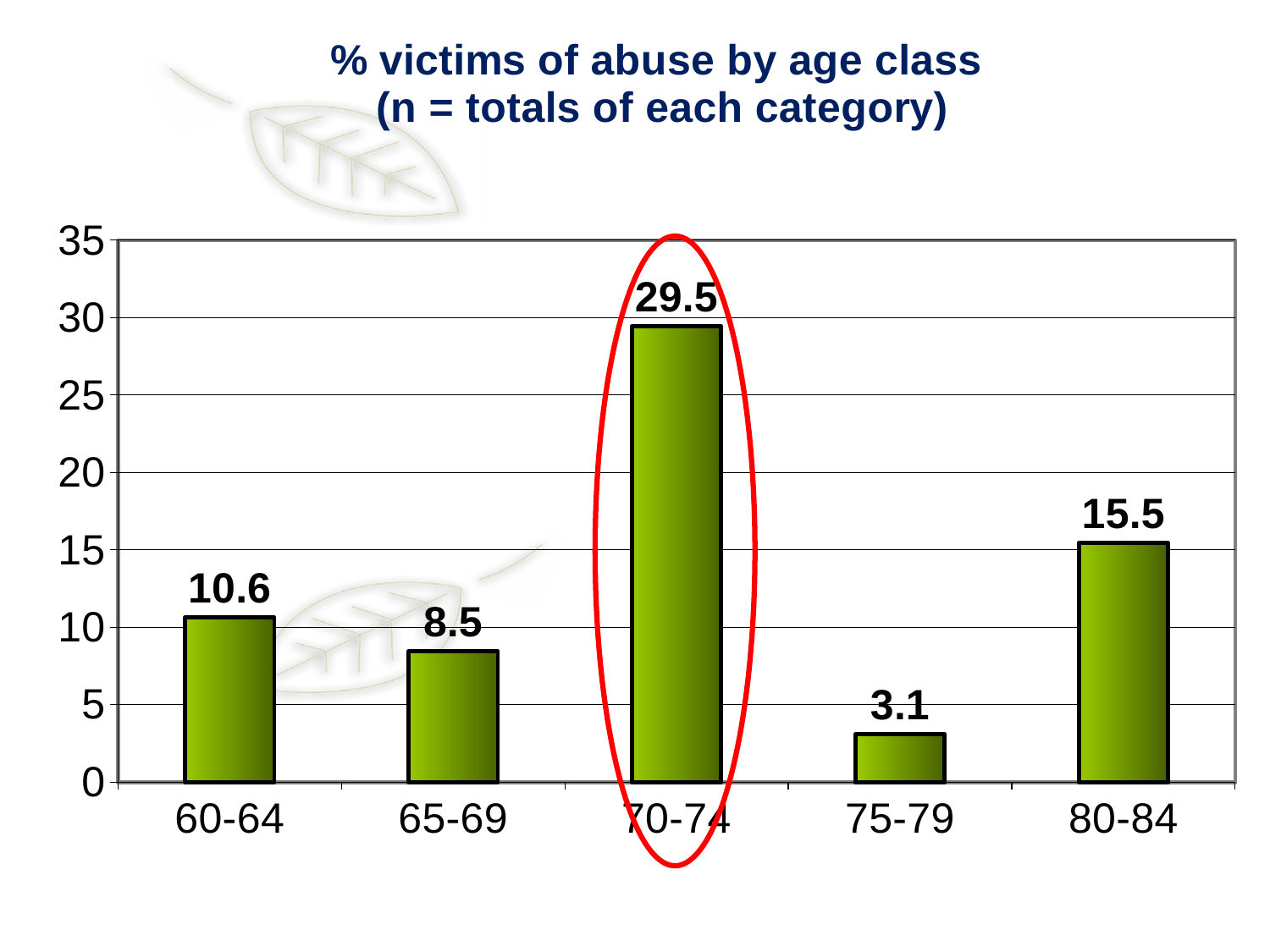
What is the value for the 70-74 age class? 29.5 What is the difference between the values for 70-74 and 80-84? 14 What kind of chart is shown on the slide? Bar chart Which is larger, the value for 60-64 or the value for 65-69? 60-64 What is the value for the 60-64 age class? 10.6 Which age class has the highest value? 70-74 How many age classes are shown on the chart? 5 Which age class is circled in red on the chart? 70-74 What is the difference between the values for 60-64 and 65-69? 2.1 Which age class has the lowest value? 75-79 What is the value for the 75-79 age class? 3.1 What is the value for the 80-84 age class? 15.5